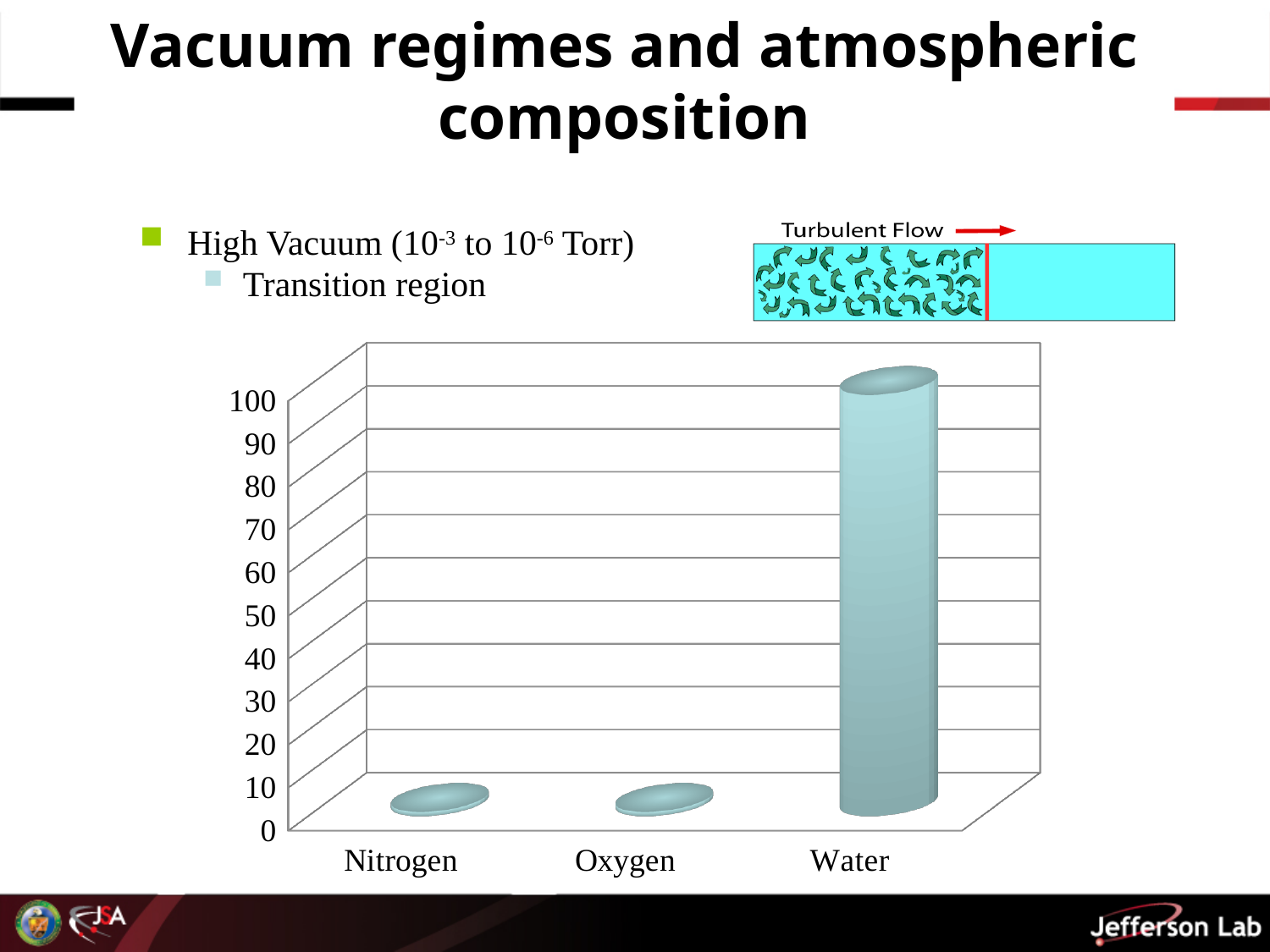
What are the three category labels on the x axis of the chart? Nitrogen, Oxygen, Water What is the highest tick value shown on the vertical axis of the chart? 100 How many categories are shown on the x axis of the chart? 3 Which is larger, the value for Water or the value for Nitrogen? Water Is the value for Oxygen greater or less than 10? less Is the value for Water greater or less than 90? greater Which category has the highest bar in the chart? Water Is the value for Nitrogen greater or less than 10? less Which is larger, the value for Oxygen or the value for Water? Water What kind of chart is shown on the slide? bar chart